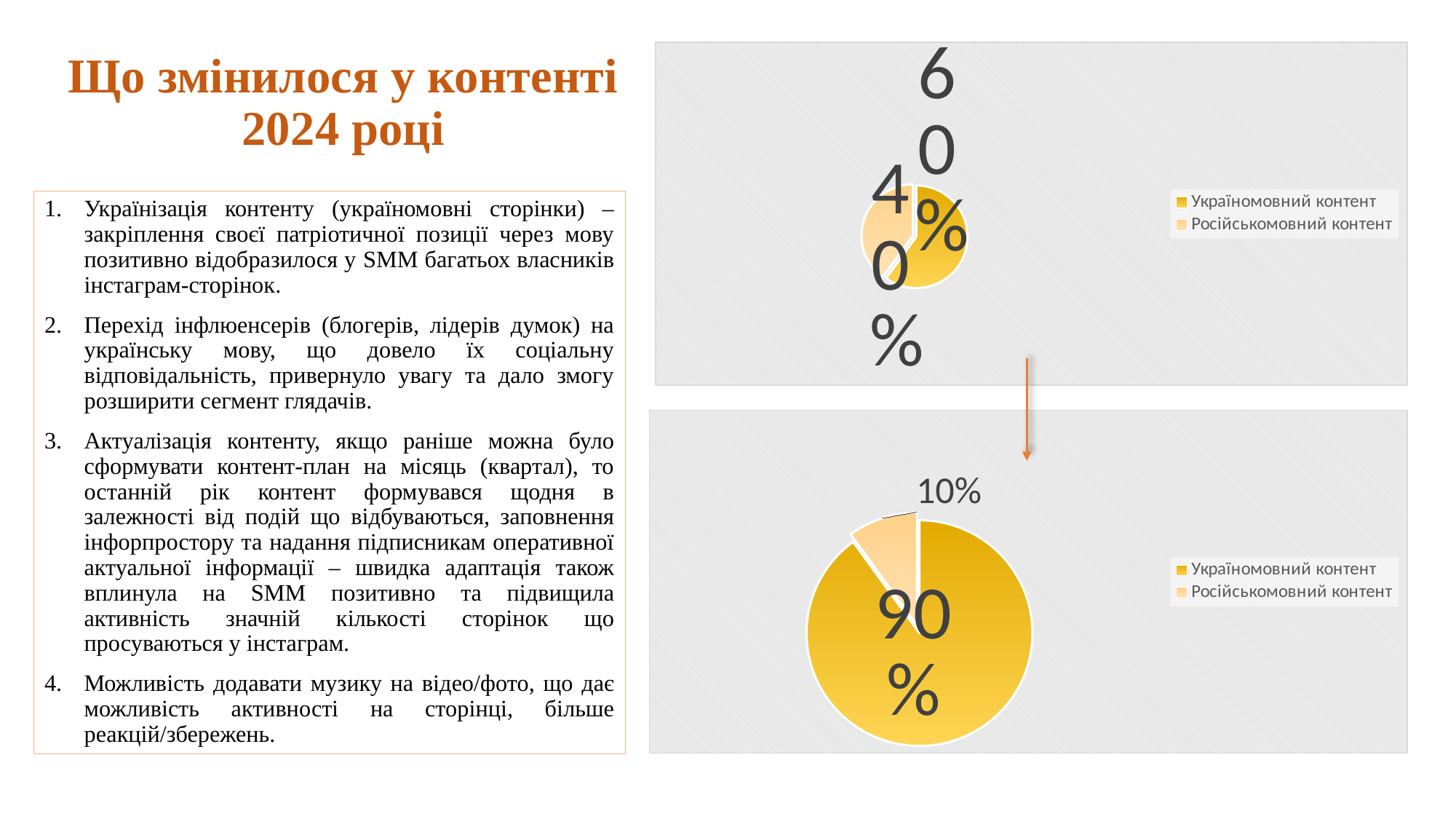
In the bottom pie chart, what share does Російськомовний контент have? 10% In the bottom pie chart, which category has the smallest slice? Російськомовний контент What kind of chart is the bottom chart on the slide? pie chart In the bottom pie chart, which category has the largest slice? Україномовний контент In the bottom pie chart, what share does Україномовний контент have? 90% How many slices does the top pie chart have? 2 In the bottom pie chart, which colour represents Російськомовний контент? light yellow How many entries does the legend of the bottom pie chart list? 2 In the top pie chart, what share does Російськомовний контент have? 40% In the top pie chart, which category has the larger slice? Україномовний контент In the bottom pie chart, what is the difference between the shares of Україномовний контент and Російськомовний контент? 80% In the top pie chart, what share does Україномовний контент have? 60%